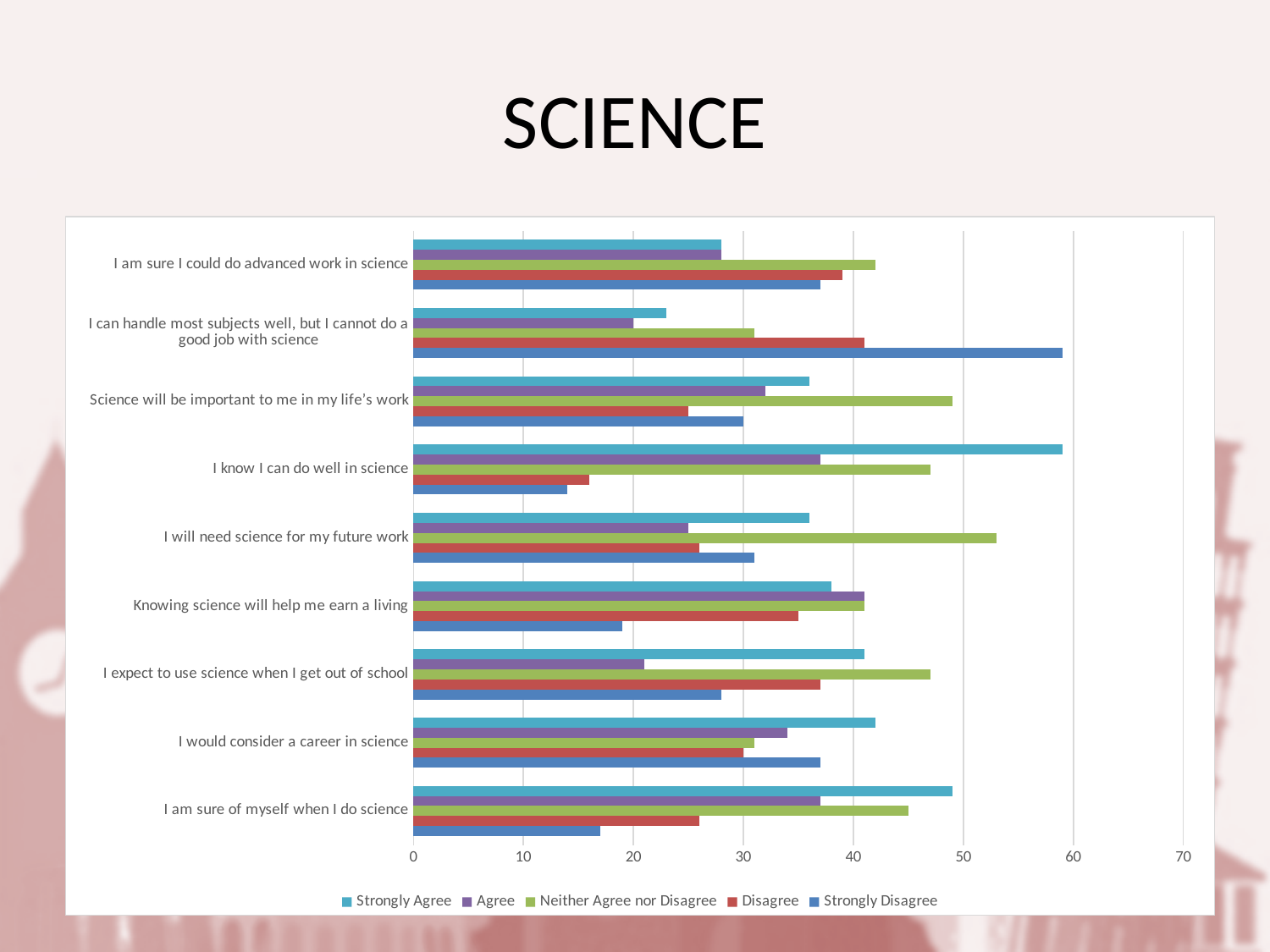
How many series does the legend list? 5 Which statement has the lowest Disagree value? I know I can do well in science Is the Strongly Disagree value for "I can handle most subjects well, but I cannot do a good job with science" greater or less than 50? greater Is the Agree value for "I expect to use science when I get out of school" greater or less than 30? less Which statement has the highest Strongly Agree value? I know I can do well in science Which statement has the highest Strongly Disagree value? I can handle most subjects well, but I cannot do a good job with science Is the Strongly Agree value for "I know I can do well in science" greater or less than 50? greater How many statements (categories) are plotted on the chart? 9 What kind of chart is shown on the slide? Bar chart What is the title of the slide containing the chart? SCIENCE For "I know I can do well in science", which is larger: Strongly Agree or Strongly Disagree? Strongly Agree